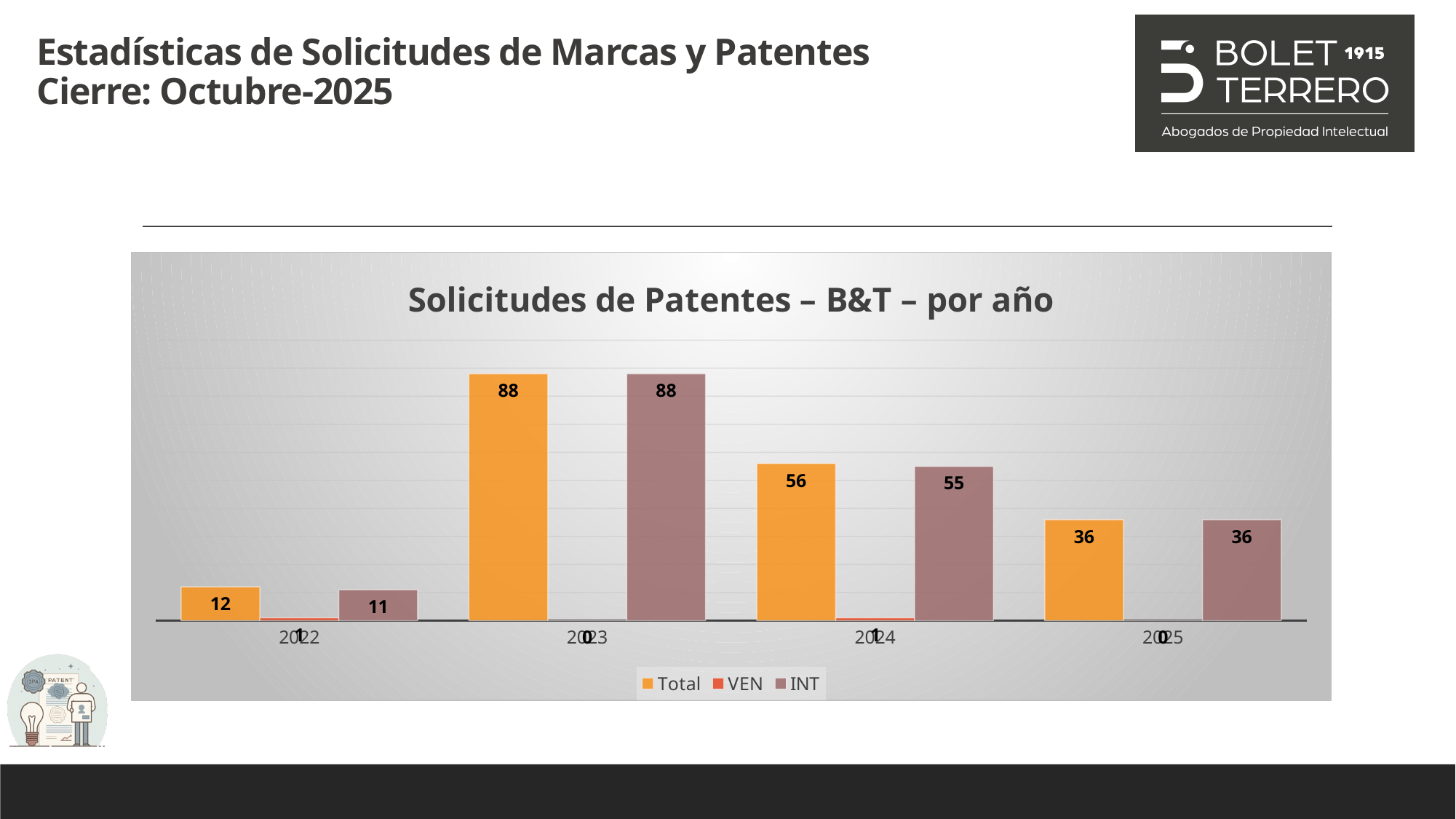
Which year has the highest Total value? 2023 What kind of chart is shown on the slide? bar chart What is the Total value for 2025? 36 What is the Total value for 2023? 88 How many years are shown on the x axis? 4 How many series does the legend list? 3 Which is larger for 2024, the Total value or the INT value? Total Which year has the lowest Total value? 2022 What is the INT value for 2022? 11 What is the difference between the Total values for 2023 and 2024? 32 What is the INT value for 2024? 55 Do the Total values rise or fall from 2023 to 2025? fall